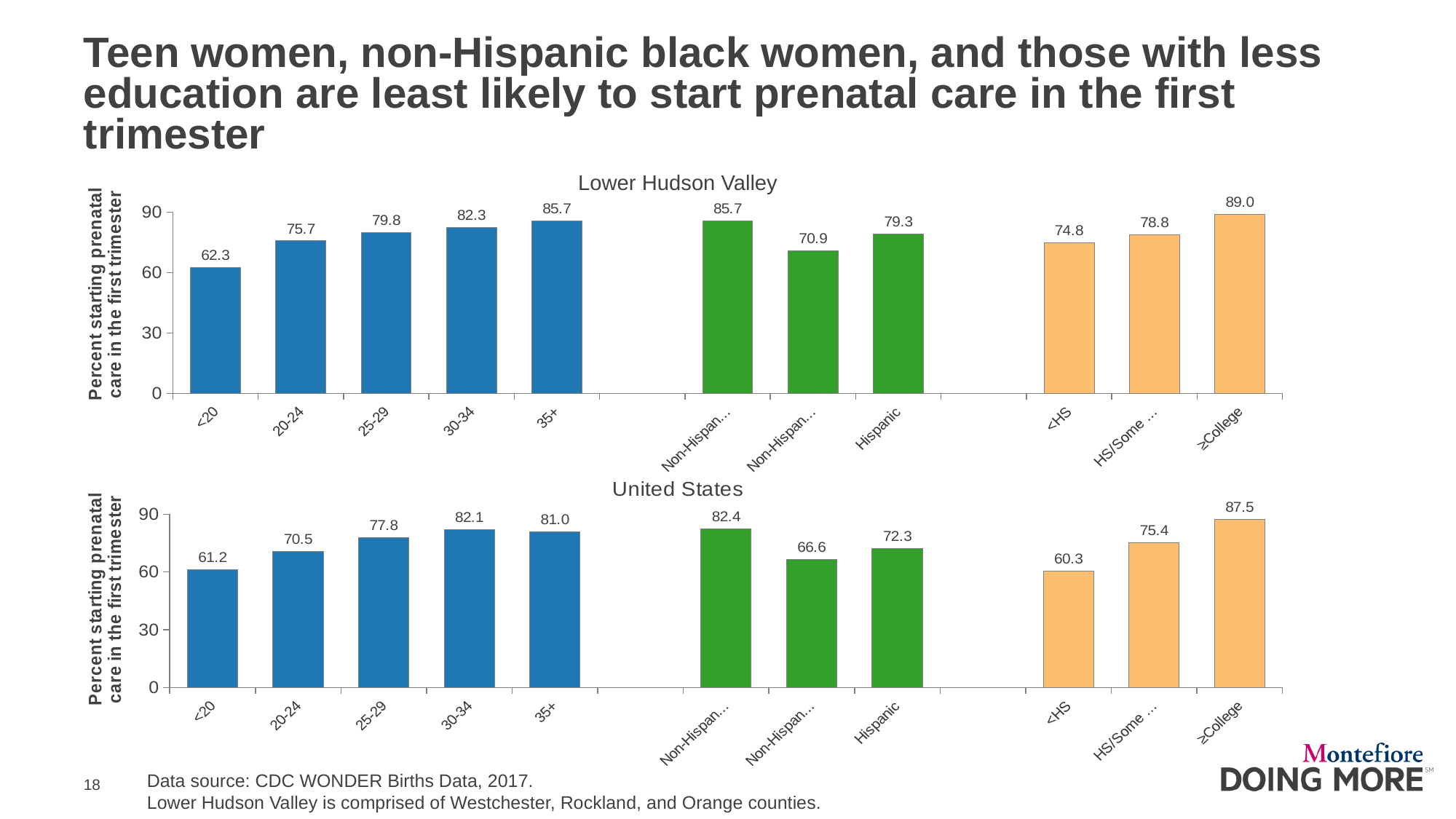
In the Lower Hudson Valley chart, what is the value for Hispanic? 79.3 In the United States chart, what is the value for ≥College? 87.5 What kind of chart is the United States chart? bar chart In the Lower Hudson Valley chart, which category has the highest value? ≥College In the Lower Hudson Valley chart, what is the difference between the values for ≥College and <HS? 14.2 In the United States chart, which category has the lowest value? <HS In the United States chart, which is larger, the value for 30-34 or the value for 35+? 30-34 In the United States chart, what is the value for <HS? 60.3 In the United States chart, is the value for 25-29 greater or less than 60? greater How many bars are plotted in the Lower Hudson Valley chart? 11 In the Lower Hudson Valley chart, what is the value for the <20 age group? 62.3 In the Lower Hudson Valley chart, do the values rise or fall across the age groups from <20 to 35+? rise